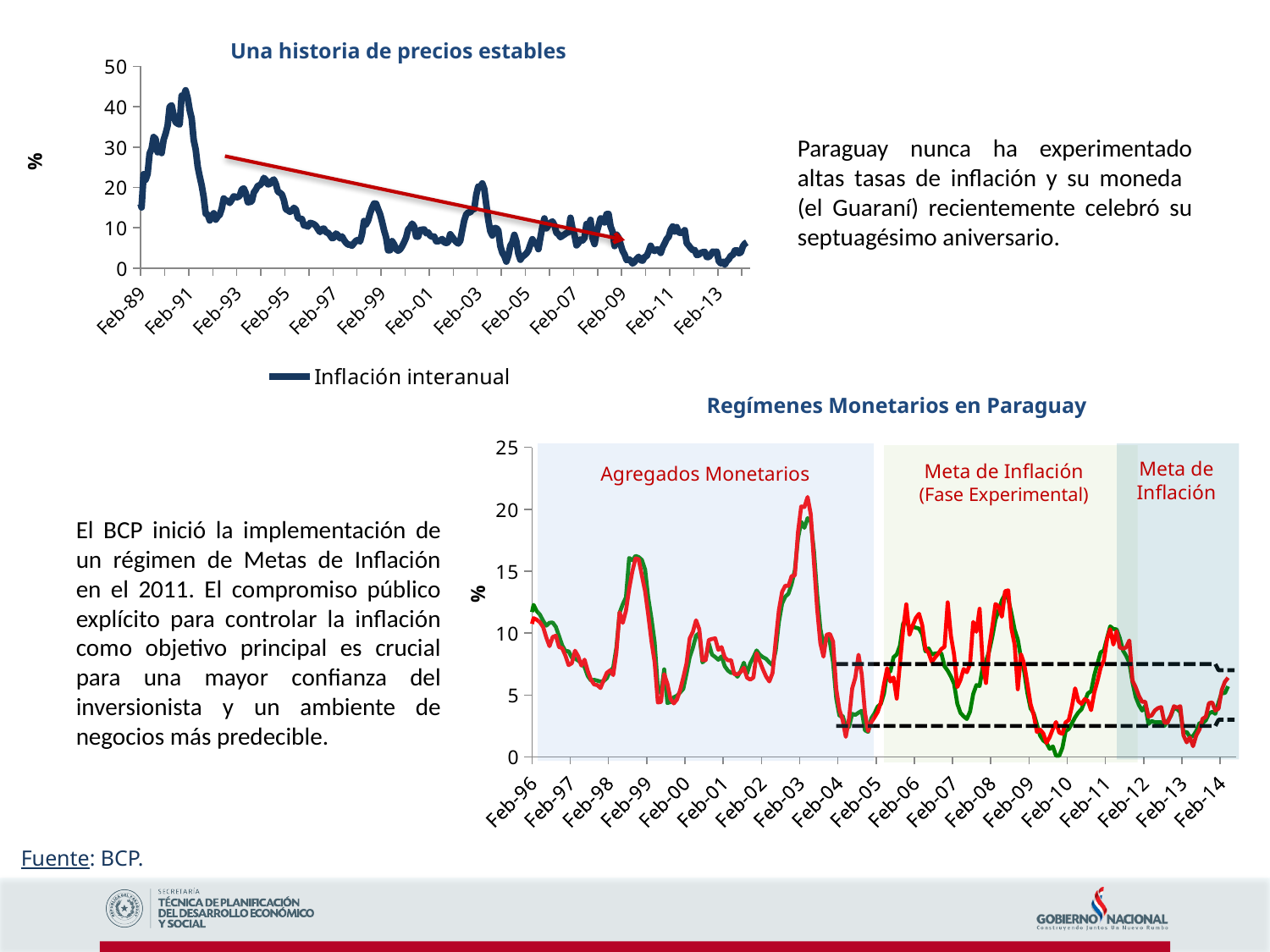
In the chart 'Una historia de precios estables', is the value at Feb-13 greater or less than 10? less In the chart 'Una historia de precios estables', what is the highest value shown on the y axis? 50 What kind of chart is 'Regímenes Monetarios en Paraguay'? line chart In the chart 'Una historia de precios estables', is the value around Feb-91 greater or less than 30? greater In the chart 'Una historia de precios estables', do the values generally rise or fall from Feb-89 to Feb-13? fall In the chart 'Regímenes Monetarios en Paraguay', is the peak value around Feb-03 greater or less than 15? greater In the chart 'Una historia de precios estables', what is the name of the series shown in the legend? Inflación interanual In the chart 'Una historia de precios estables', how many series does the legend list? 1 In the chart 'Regímenes Monetarios en Paraguay', how many x-axis tick labels are shown from Feb-96 to Feb-14? 19 What kind of chart is 'Una historia de precios estables'? line chart In the chart 'Regímenes Monetarios en Paraguay', how many monetary regimes are labelled on the chart? 3